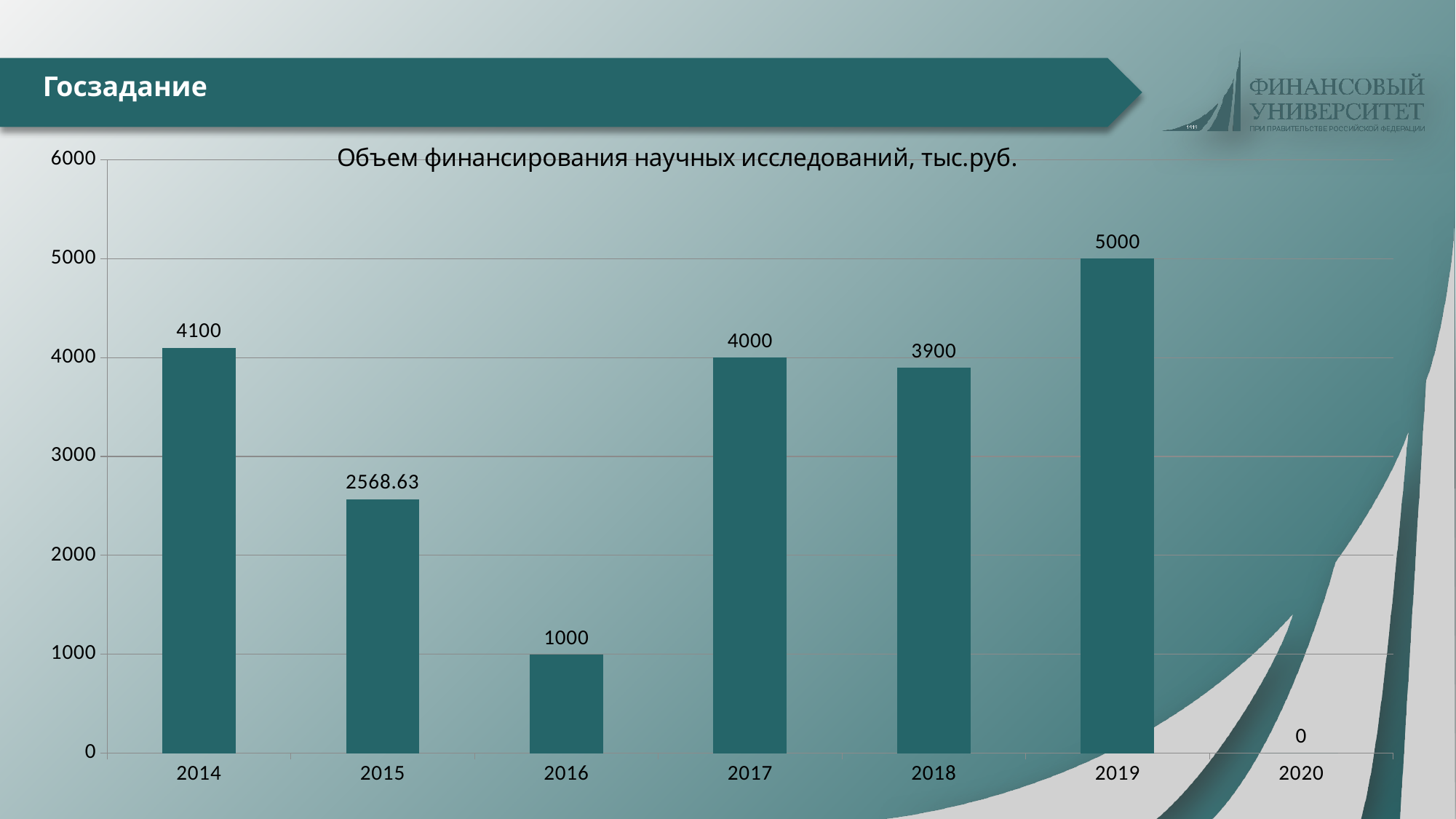
How many years are shown on the x axis? 7 What is the value for 2015? 2568.63 What kind of chart is shown on the slide? bar chart What is the value for 2014? 4100 What is the difference between the values for 2019 and 2018? 1100 Which year has the lowest value? 2020 What is the value for 2016? 1000 What is the value for 2020? 0 Is the value for 2015 greater or less than 3000? less What is the title of the chart? Объем финансирования научных исследований, тыс.руб. Which year has the highest value? 2019 Which is larger, the value for 2017 or the value for 2018? 2017